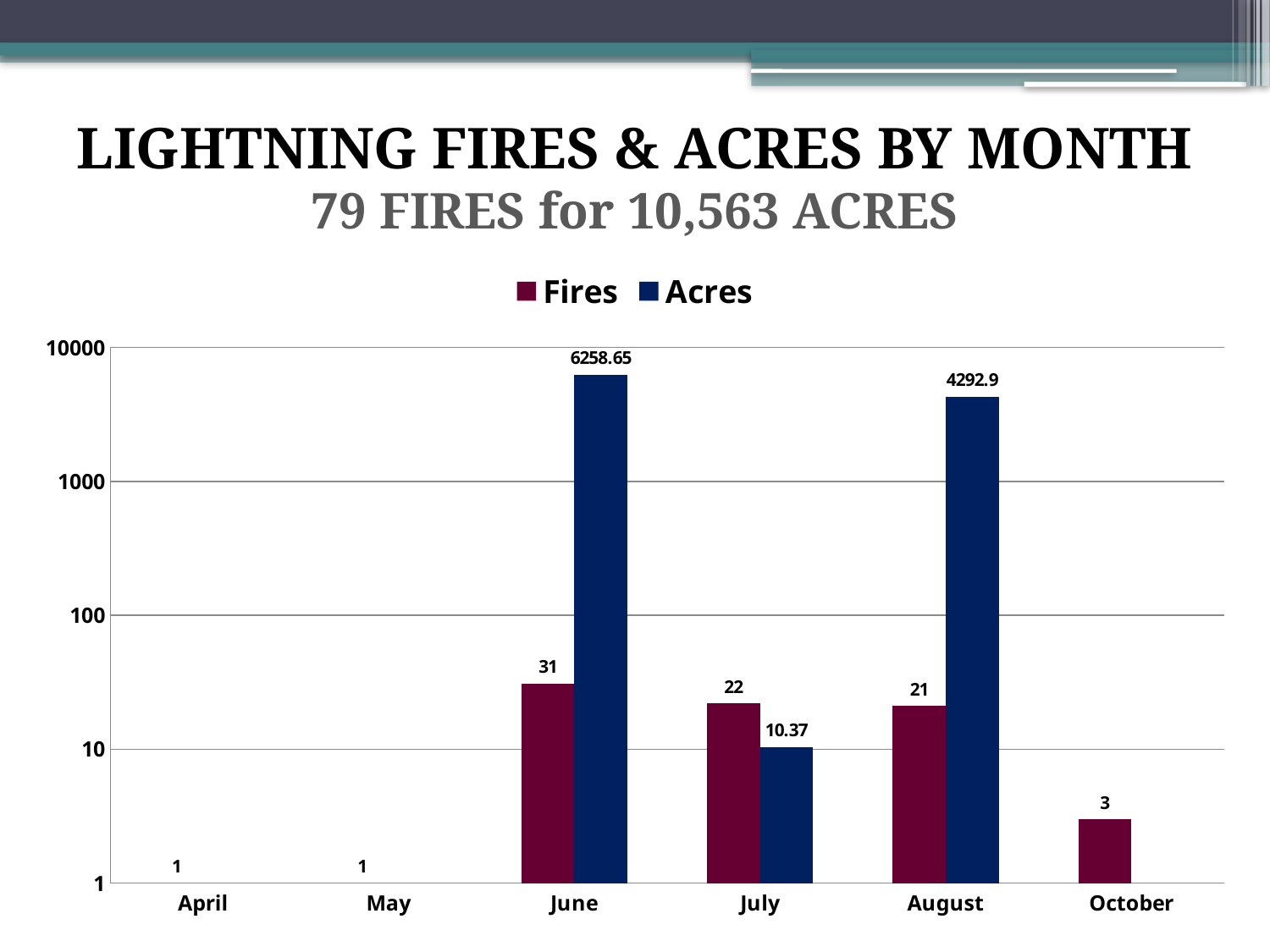
How many series does the legend list? 2 What is the number of Fires in June? 31 What is the title of the chart on the slide? LIGHTNING FIRES & ACRES BY MONTH What is the Acres value for August? 4292.9 What is the number of Fires in October? 3 Which month has the highest Acres value? June Which month has the highest number of Fires? June What is the difference in Fires between June and July? 9 What is the Acres value for July? 10.37 What type of chart is shown on the slide? bar chart Which is larger, the Fires value for July or the Fires value for August? July How many months are shown on the x axis? 6